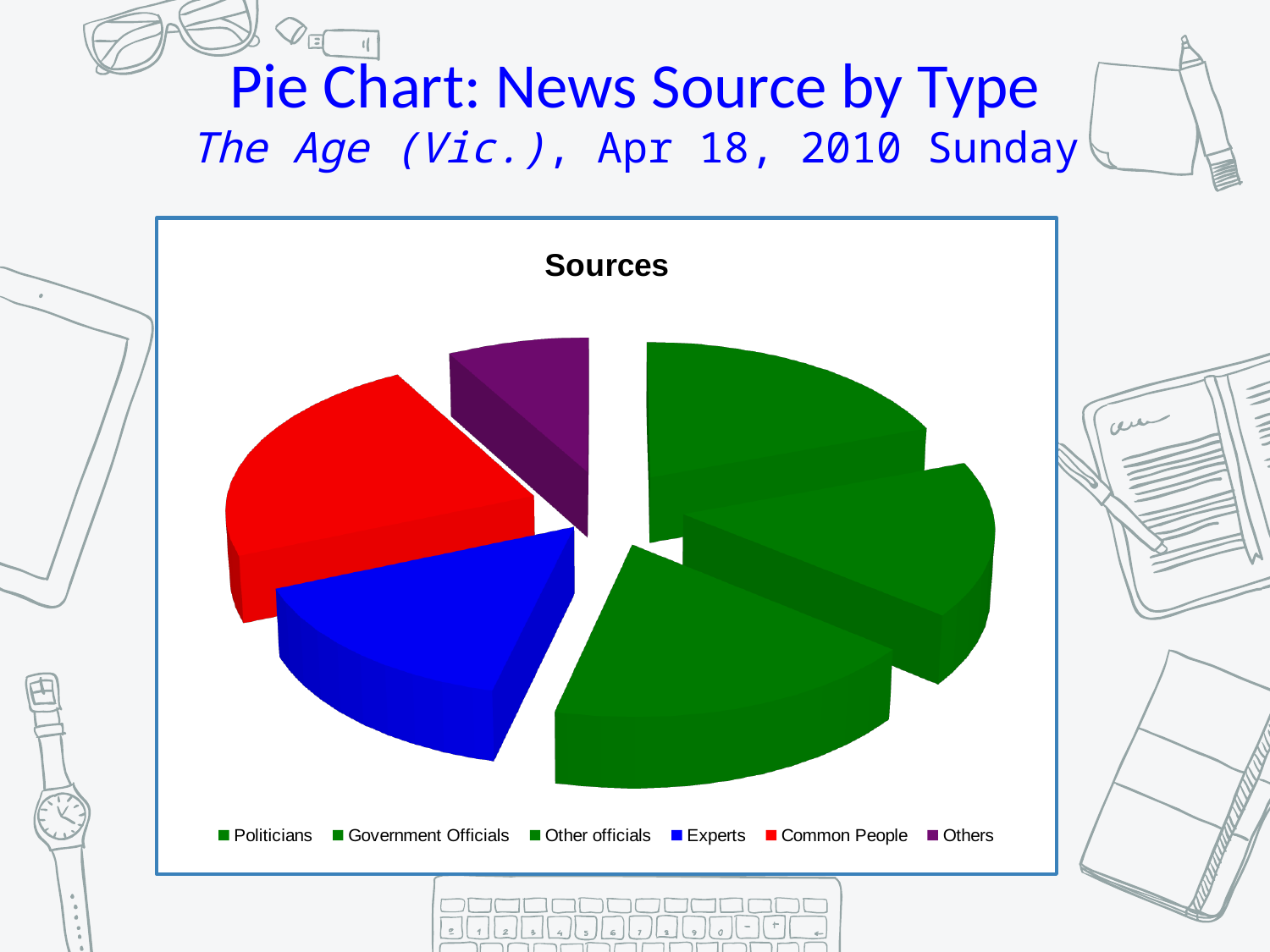
Which category has the smallest slice in the pie chart? Others Which slice is larger, Common People or Others? Common People Which category is shown in purple in the pie chart? Others How many slices does the pie chart have? 6 What kind of chart is shown on the slide? Pie chart What is the title of the chart? Sources Which category is shown in blue in the pie chart? Experts How many categories does the legend of the chart list? 6 Which slice is larger, Experts or Others? Experts